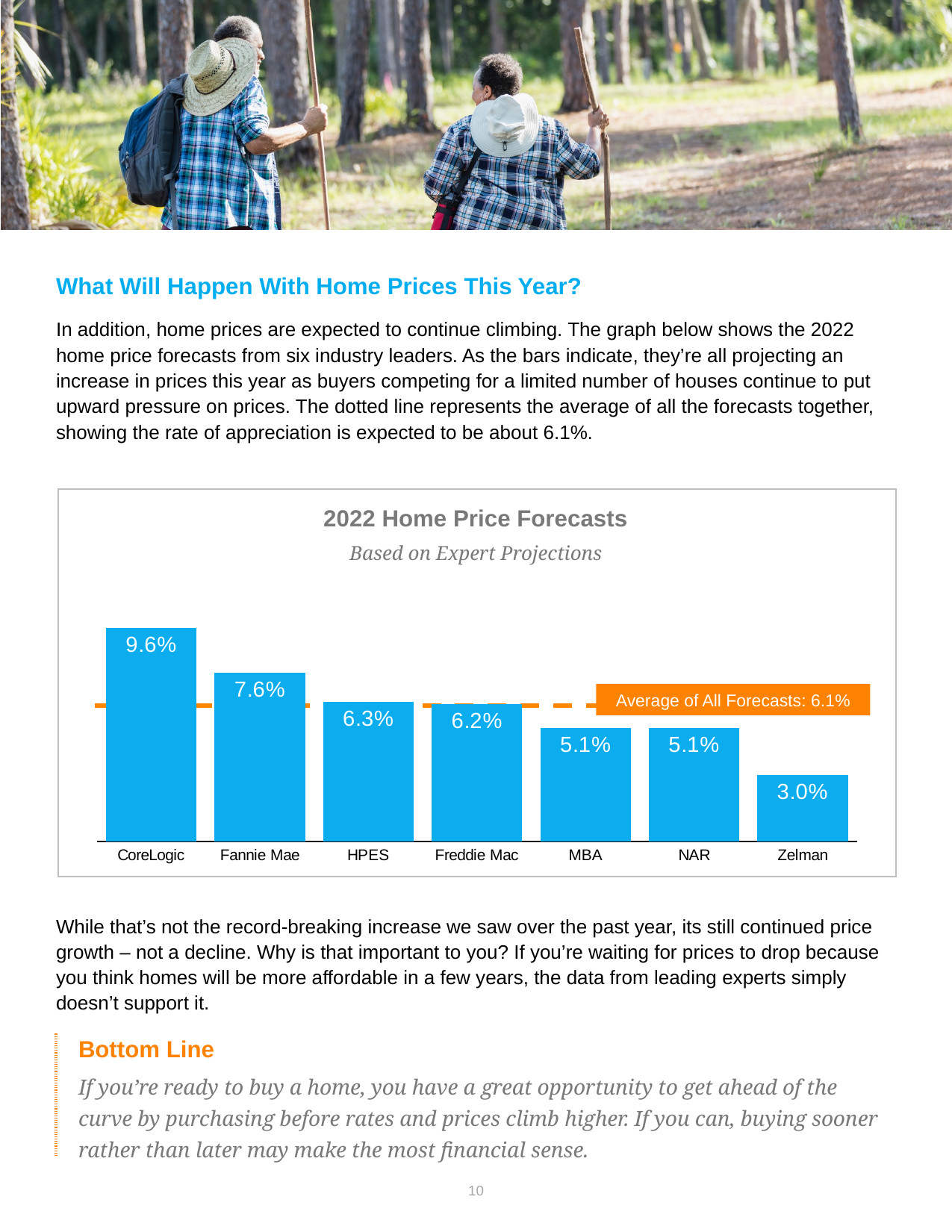
What kind of chart is shown on the slide? Bar chart What is the 2022 home price forecast for Zelman? 3.0% Which is larger, the Fannie Mae forecast or the HPES forecast? Fannie Mae Do the forecast values generally rise or fall from left to right across the chart? Fall How many forecasters are shown in the chart? 7 Which forecaster has the highest 2022 home price forecast? CoreLogic What is the 2022 home price forecast for CoreLogic? 9.6% What value does the dotted line labelled 'Average of All Forecasts' represent? 6.1% What is the 2022 home price forecast for Freddie Mac? 6.2% Which forecaster has the lowest 2022 home price forecast? Zelman What is the difference between the CoreLogic and Fannie Mae forecasts? 2.0% What is the difference between the HPES and Zelman forecasts? 3.3%